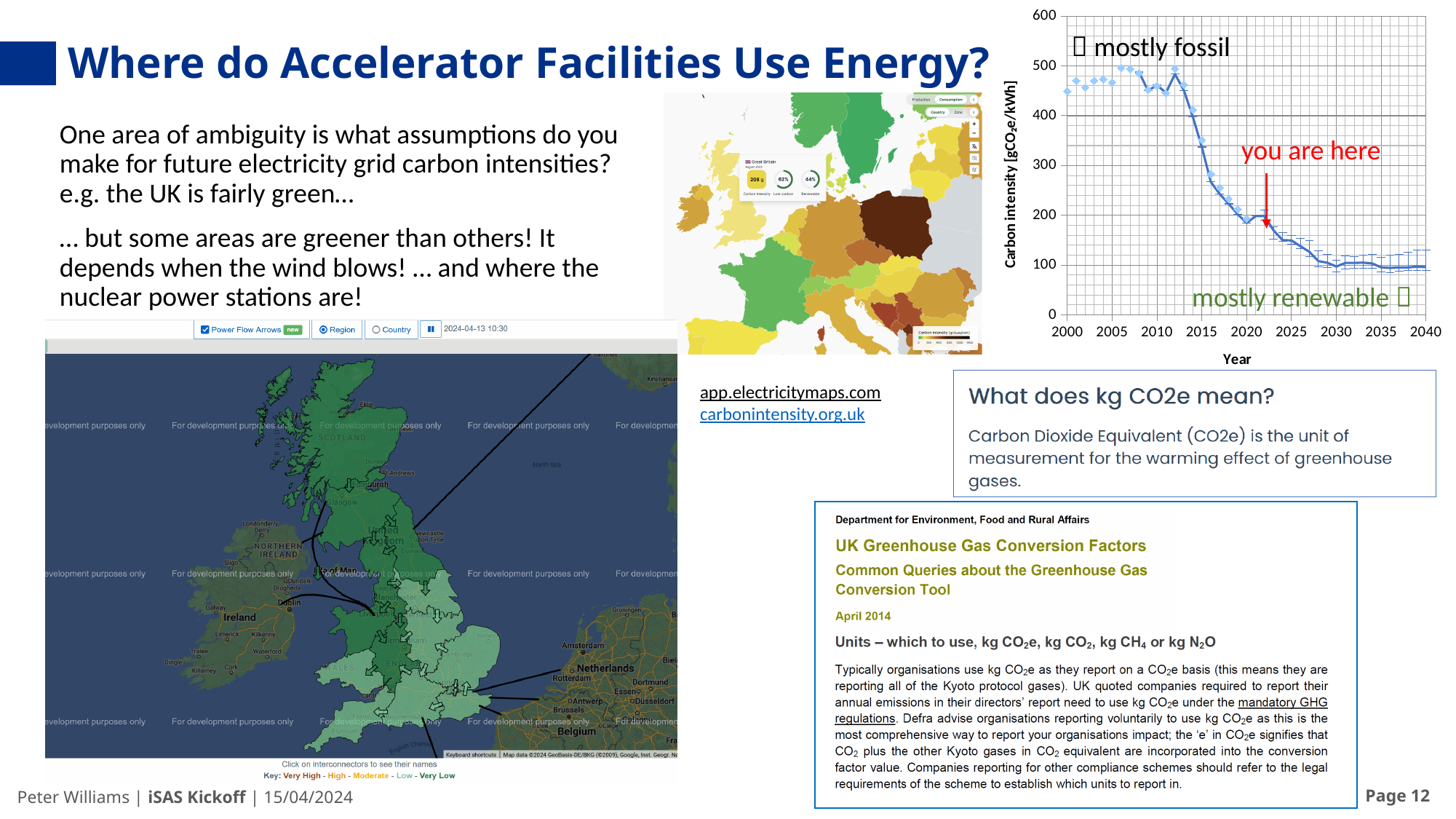
What kind of chart is the carbon intensity chart on the right of the slide? line chart In the carbon intensity chart, which year has the larger value, 2015 or 2035? 2015 In the carbon intensity chart, do the values generally rise or fall from 2000 to 2040? fall In the carbon intensity chart, is the value for 2030 greater or less than 200? less In the carbon intensity chart, which year has the larger value, 2005 or 2030? 2005 In the carbon intensity chart, is the value for 2010 greater or less than 400? greater In the carbon intensity chart, is the value for 2020 greater or less than 300? less What is the y-axis label of the carbon intensity chart? Carbon intensity [gCO2e/kWh] What red annotation is placed on the carbon intensity chart near 2022? you are here